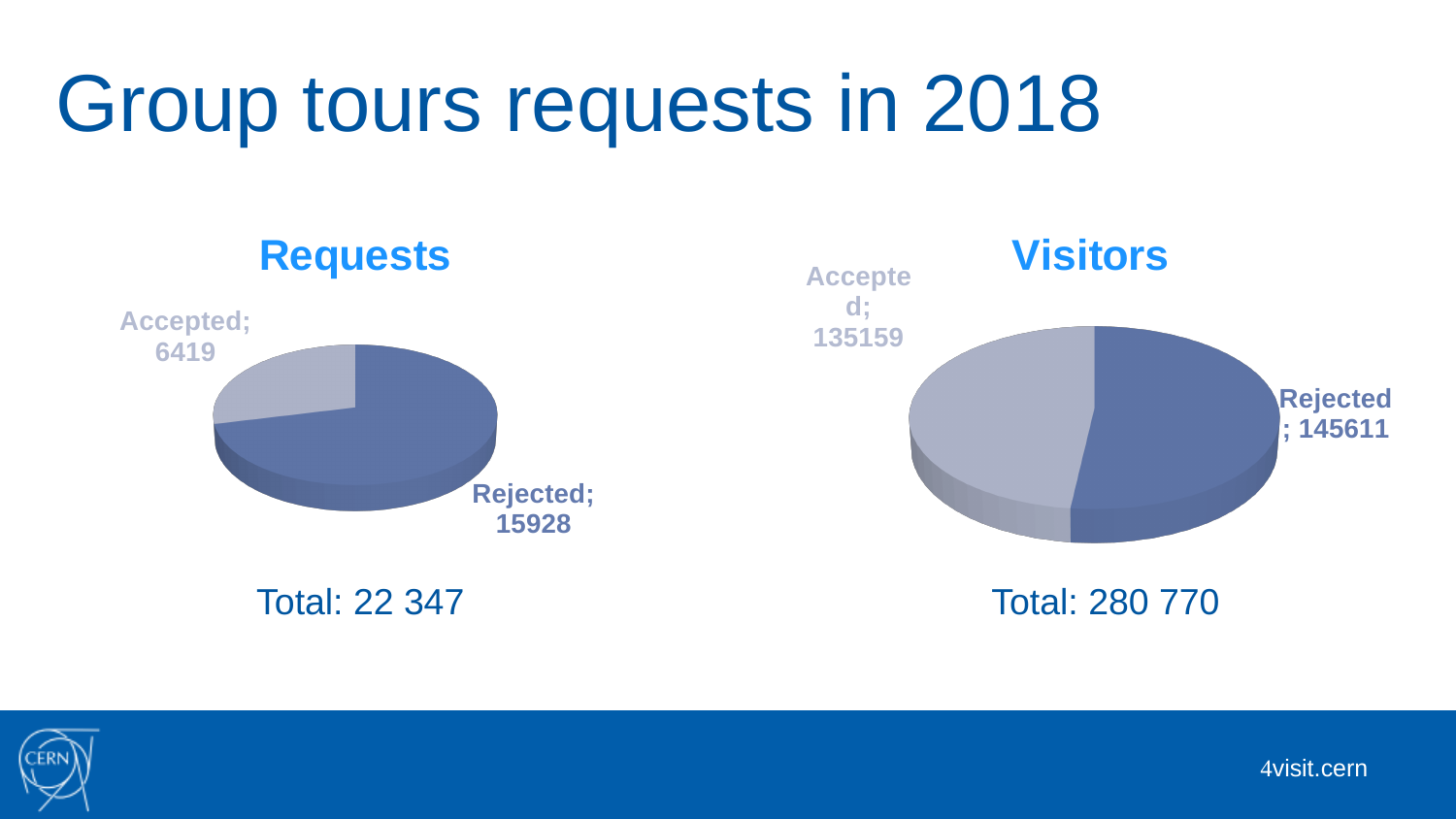
In the Visitors chart, what is the value for Rejected? 145611 In the Visitors chart, which slice is the smallest? Accepted In the Requests chart, what is the value for Accepted? 6419 In the Requests chart, what is the difference between Rejected and Accepted? 9509 In the Visitors chart, which is larger, Accepted or Rejected? Rejected What total is shown below the Visitors chart? 280 770 What kind of chart is the Requests chart? pie chart In the Visitors chart, what is the difference between Rejected and Accepted? 10452 In the Visitors chart, what is the value for Accepted? 135159 In the Requests chart, what is the value for Rejected? 15928 In the Requests chart, which slice is the largest? Rejected How many slices does the Requests chart have? 2